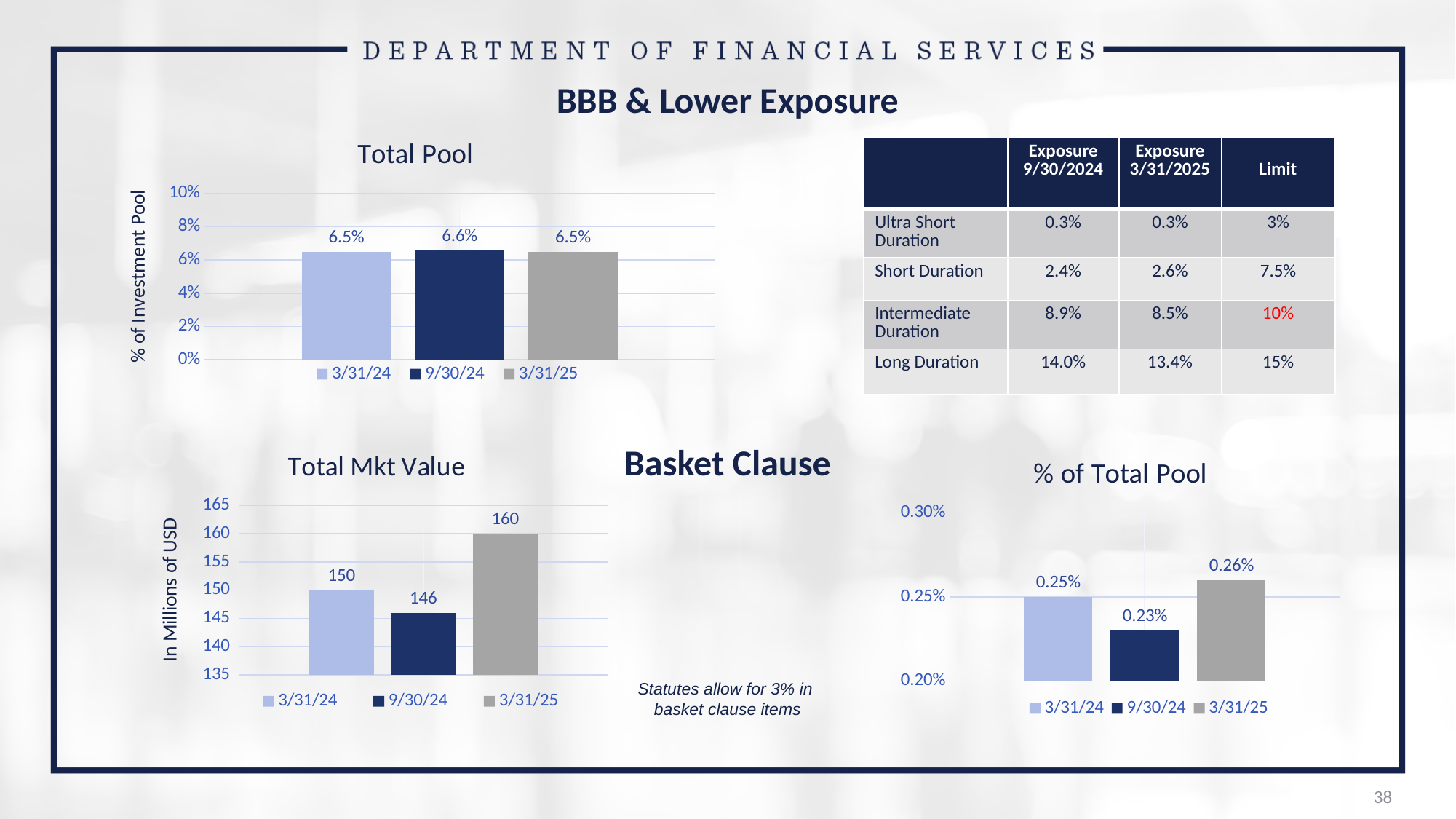
In the Total Mkt Value chart, what is the y-axis label? In Millions of USD In the Total Pool chart, which date has the highest value? 9/30/24 In the Total Pool chart, what is the value for 9/30/24? 6.6% In the Total Mkt Value chart, which date has the lowest value? 9/30/24 In the Total Mkt Value chart, what is the value for 3/31/25? 160 What kind of chart is the % of Total Pool chart? bar chart In the % of Total Pool chart, which date has the highest value? 3/31/25 In the Total Mkt Value chart, how many bars are plotted? 3 In the Total Mkt Value chart, what is the difference between the 3/31/25 and 9/30/24 values? 14 In the % of Total Pool chart, what is the value for 9/30/24? 0.23% In the % of Total Pool chart, which is larger, the value for 3/31/24 or the value for 9/30/24? 3/31/24 In the Total Pool chart, how many series does the legend list? 3